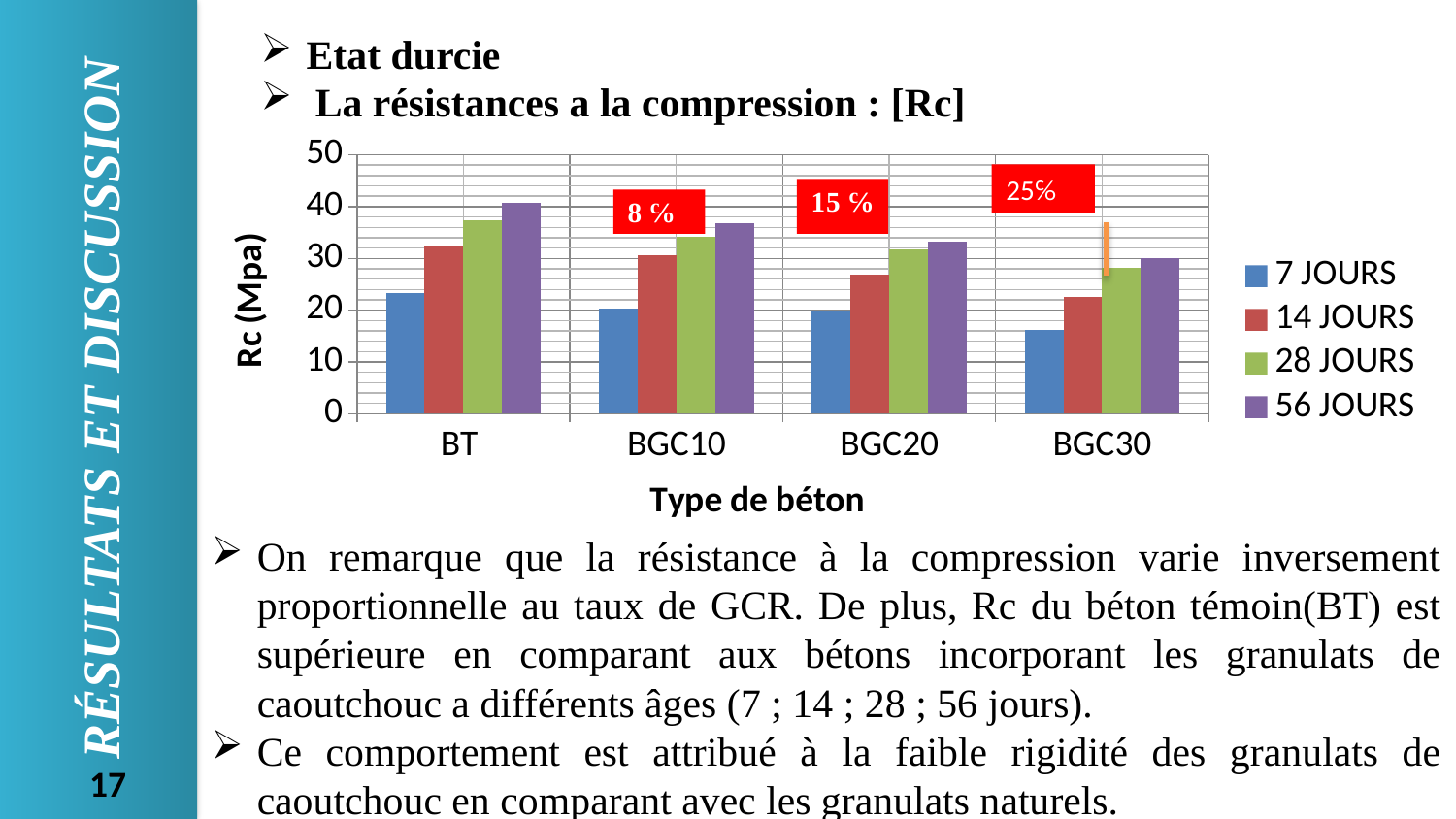
What kind of chart is shown on the slide? bar chart Which concrete type has the lowest 7 JOURS value? BGC30 What percentage label is shown above the BGC20 group? 15 % How many concrete types (categories) are shown on the x axis? 4 Which concrete type has the highest 56 JOURS value? BT What is the title of the y axis? Rc (Mpa) Is the 56 JOURS value for BT greater or less than 40? greater Is the 28 JOURS value for BGC20 greater or less than 30? greater How many series does the legend list? 4 Do the 7 JOURS values rise or fall from BT to BGC30? fall Is the 7 JOURS value for BGC30 greater or less than 20? less Which is larger, the 14 JOURS value for BT or the 14 JOURS value for BGC30? BT